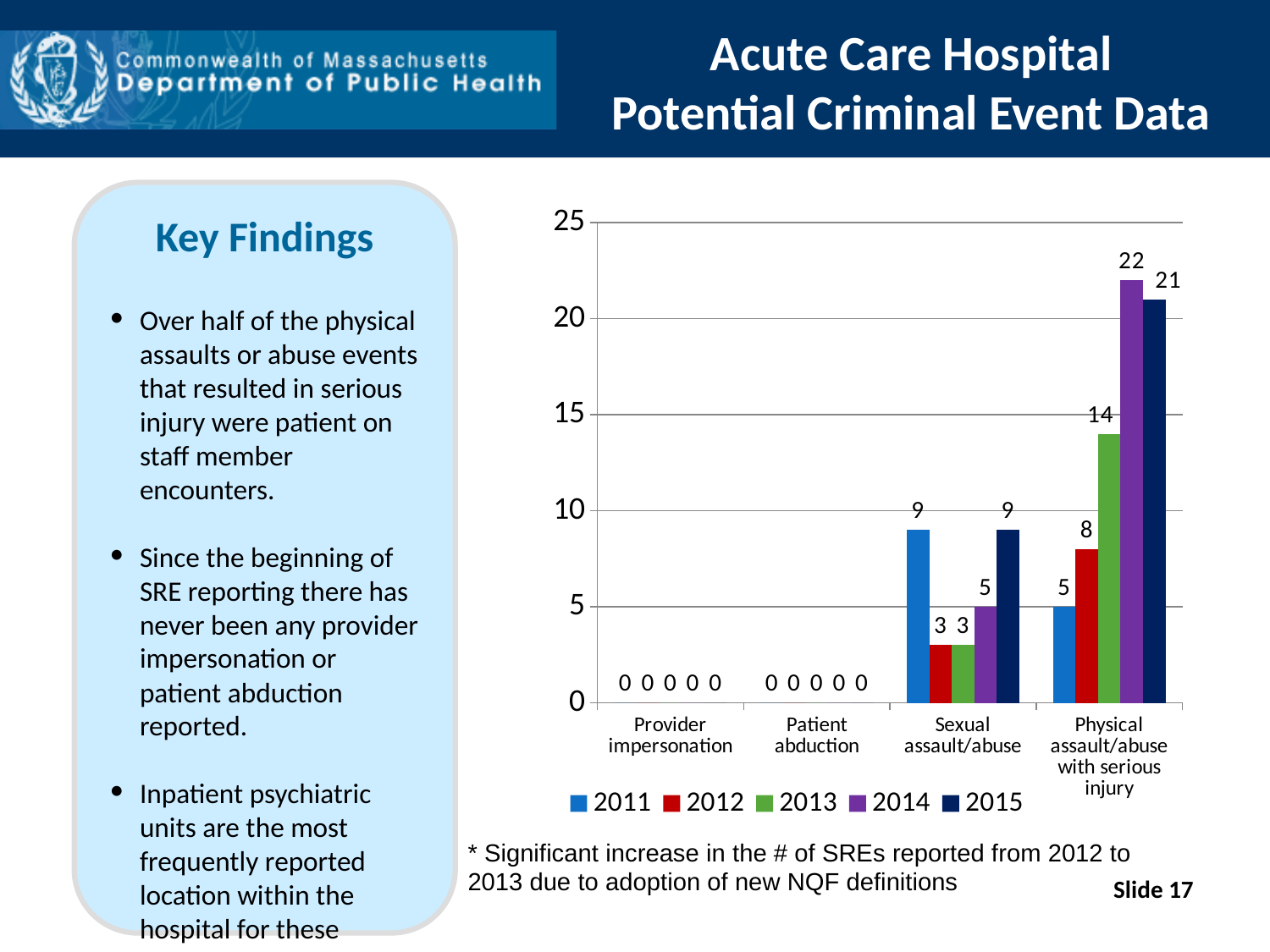
What is the difference between the 2014 and 2011 values for Physical assault/abuse with serious injury? 17 What is the value for Physical assault/abuse with serious injury in 2014? 22 Which year has the lowest value for Physical assault/abuse with serious injury? 2011 Which is larger for Sexual assault/abuse: the 2014 value or the 2012 value? 2014 Which series is shown in red in the chart legend? 2012 What kind of chart is shown on the slide? bar chart What is the value for Physical assault/abuse with serious injury in 2013? 14 What is the value for Sexual assault/abuse in 2011? 9 Which year has the highest value for Physical assault/abuse with serious injury? 2014 What is the value for Patient abduction in 2015? 0 How many categories are shown on the x axis of the chart? 4 How many series does the chart legend list? 5